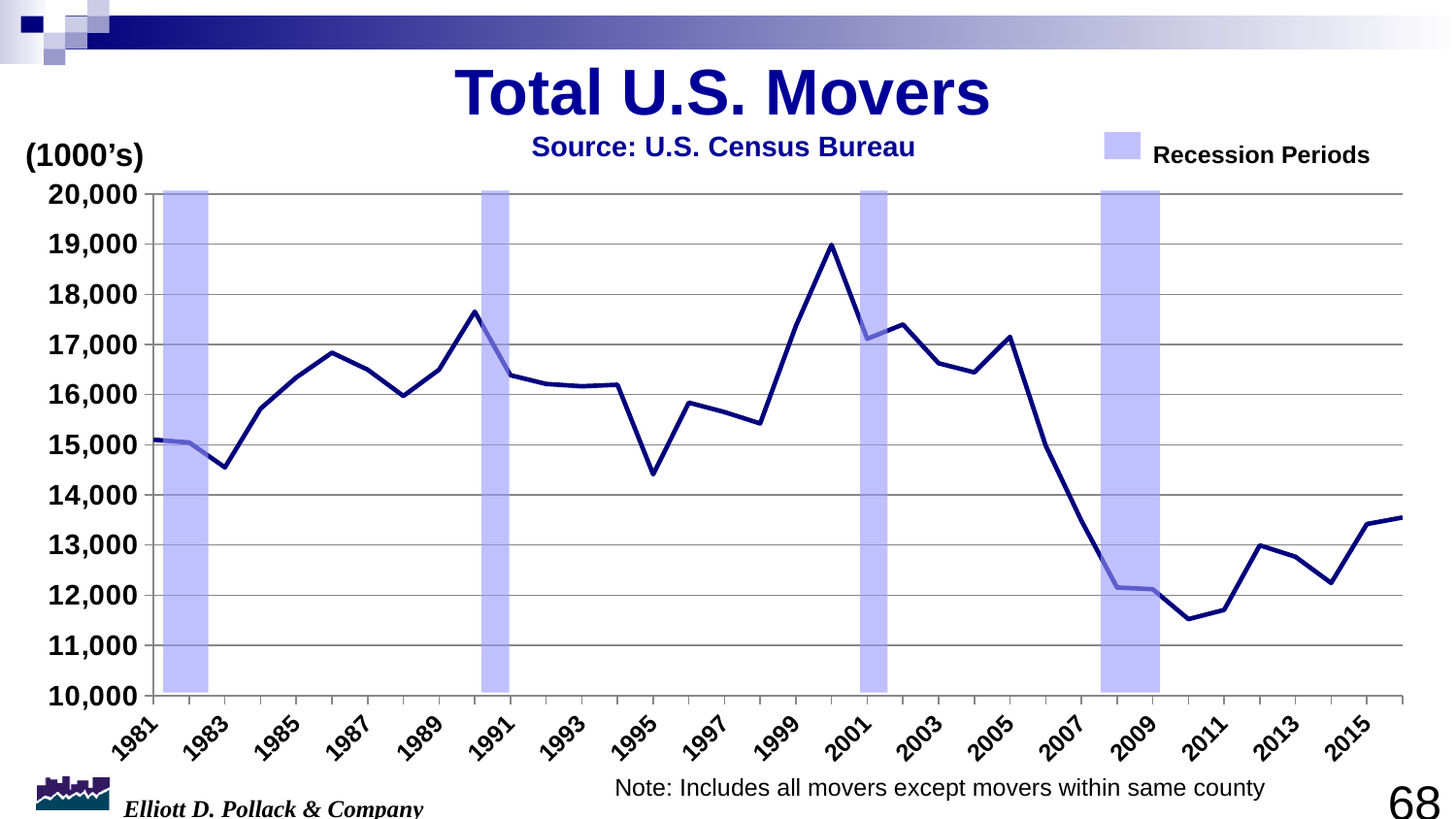
Do the values rise or fall between 2005 and 2011? fall In which year does the number of total U.S. movers reach its highest point? 2000 Is the value for 2000 greater or less than 18,000? greater Which year has a higher value, 1995 or 2011? 1995 What is the title of the chart? Total U.S. Movers Is the value for 1995 greater or less than 15,000? less What kind of chart is shown on the slide? line chart In which year does the number of total U.S. movers reach its lowest point? 2010 Is the value for 2011 greater or less than 12,000? less What do the shaded vertical bands on the chart represent? Recession Periods How many recession periods are shaded on the chart? 4